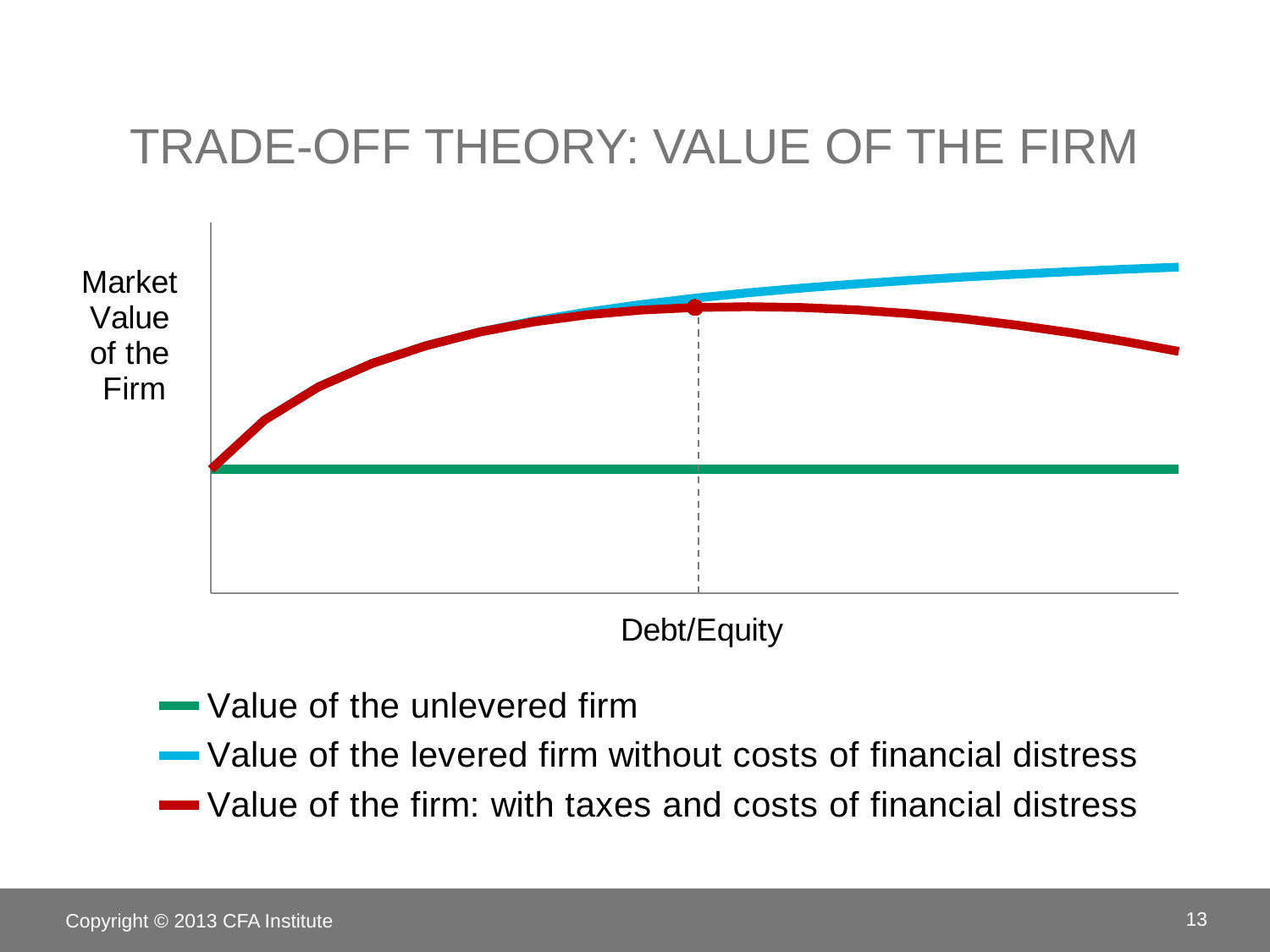
What kind of chart is shown on the slide? line chart Which series is marked with a dot at its peak where the dashed vertical line is drawn? Value of the firm: with taxes and costs of financial distress At the right end of the chart, which series has the highest value? Value of the levered firm without costs of financial distress What is the label of the y axis? Market Value of the Firm At the right end of the chart, which series has the lowest value? Value of the unlevered firm Does the green line (Value of the unlevered firm) rise, fall, or stay flat as Debt/Equity increases? stays flat Does the red line (Value of the firm: with taxes and costs of financial distress) rise or fall after the dashed vertical line? falls Does the blue line (Value of the levered firm without costs of financial distress) rise or fall as Debt/Equity increases? rises How many series does the legend list? 3 What is the label of the x axis? Debt/Equity At the right end of the chart, which is larger: the value of the unlevered firm or the value of the firm with taxes and costs of financial distress? Value of the firm: with taxes and costs of financial distress